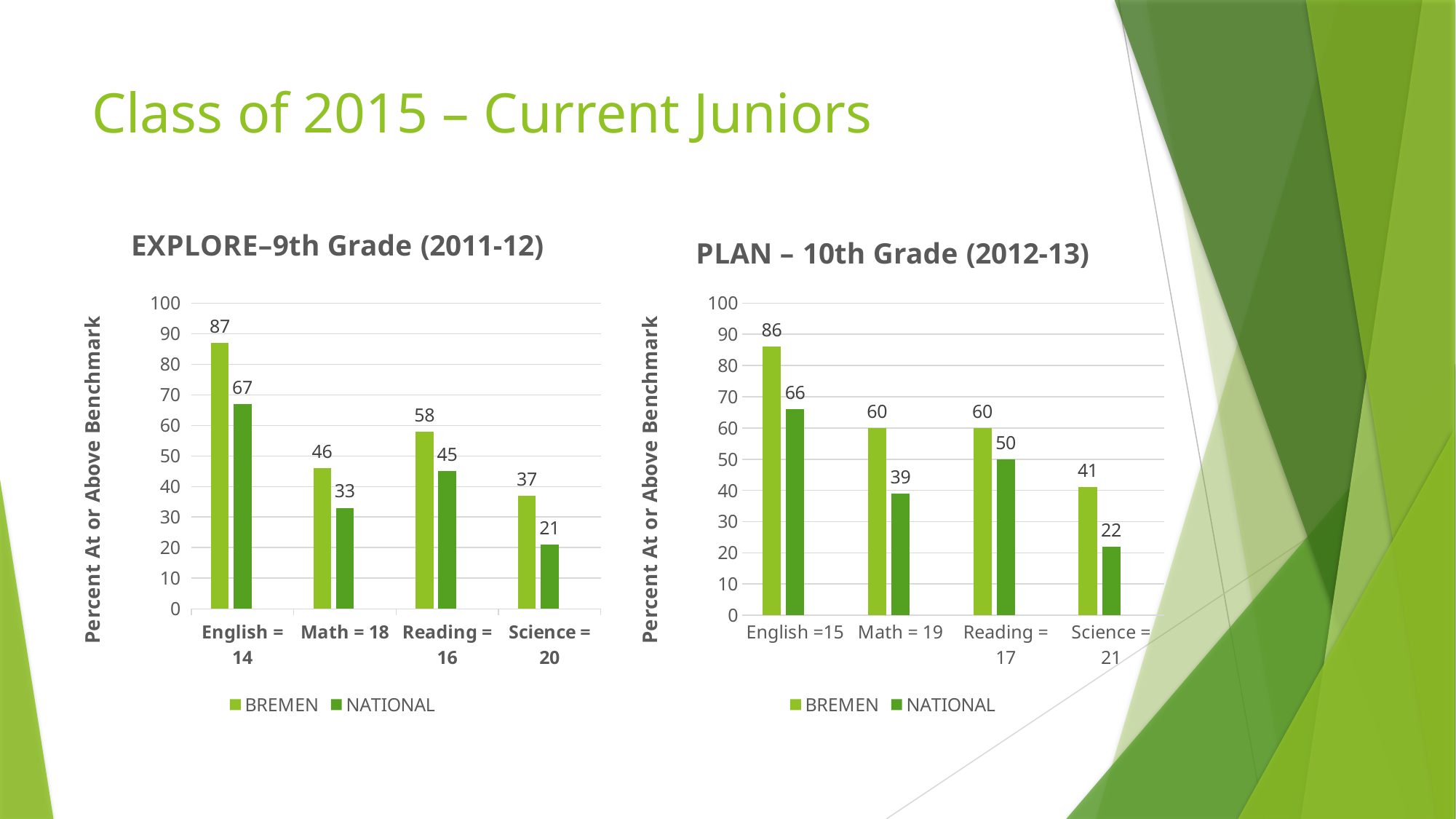
In the PLAN – 10th Grade (2012-13) chart, which category has the lowest NATIONAL value? Science = 21 In the PLAN – 10th Grade (2012-13) chart, what is the BREMEN value for Science = 21? 41 In the EXPLORE–9th Grade (2011-12) chart, which is larger for Reading = 16: the BREMEN value or the NATIONAL value? BREMEN What kind of chart is the PLAN – 10th Grade (2012-13) chart? Bar chart How many series does the legend of the EXPLORE–9th Grade (2011-12) chart list? 2 In the EXPLORE–9th Grade (2011-12) chart, what is the BREMEN value for English = 14? 87 In the EXPLORE–9th Grade (2011-12) chart, what is the NATIONAL value for Science = 20? 21 In the PLAN – 10th Grade (2012-13) chart, what is the NATIONAL value for Math = 19? 39 In the PLAN – 10th Grade (2012-13) chart, what is the difference between the BREMEN and NATIONAL values for English =15? 20 How many categories are shown on the x axis of the PLAN – 10th Grade (2012-13) chart? 4 In the EXPLORE–9th Grade (2011-12) chart, which category has the highest BREMEN value? English = 14 In the EXPLORE–9th Grade (2011-12) chart, what is the difference between the BREMEN and NATIONAL values for Math = 18? 13